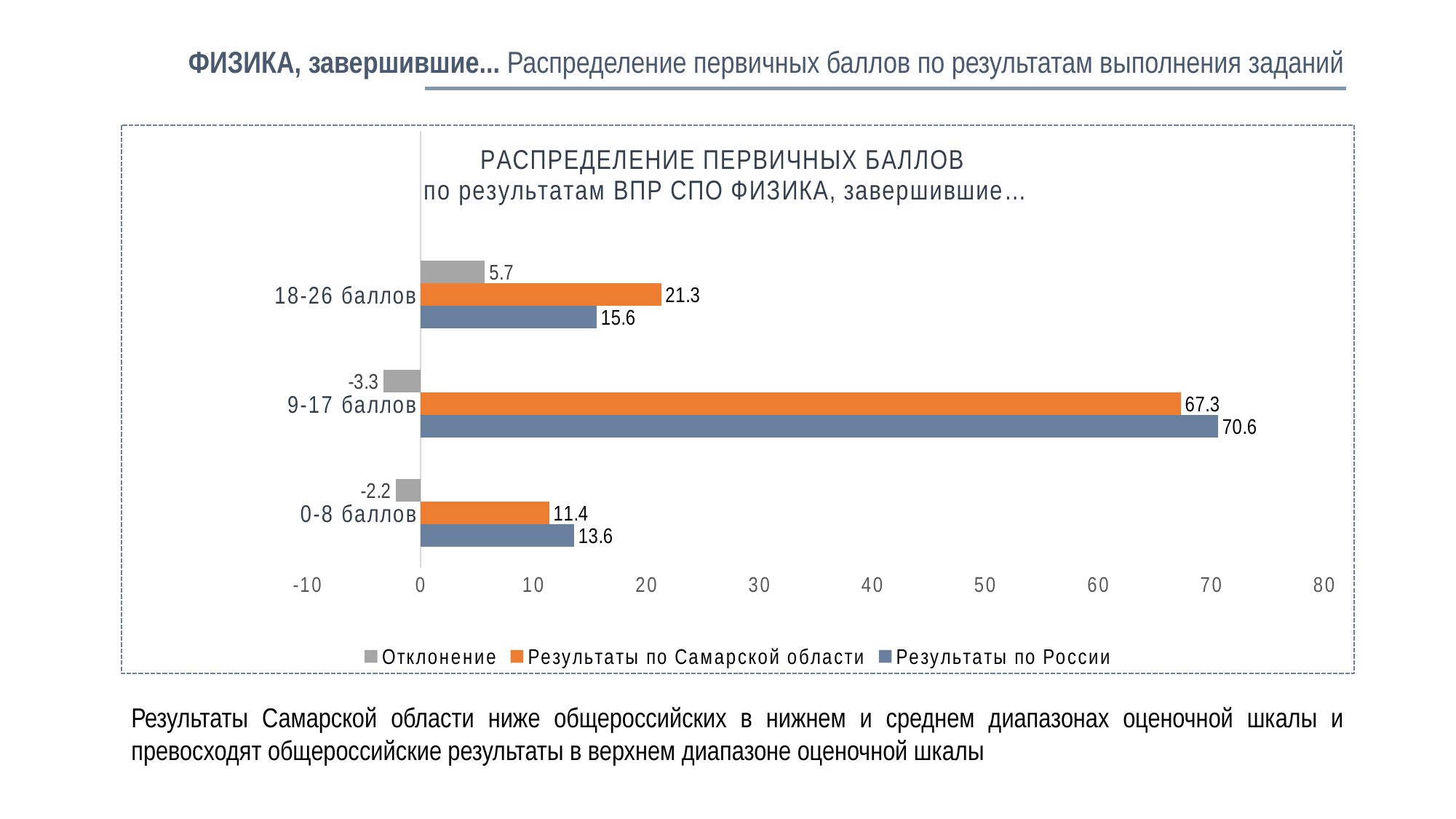
What is the Отклонение value for the 0-8 баллов category? -2.2 How many score-range categories are shown on the chart? 3 Which category has the highest value for Результаты по России? 9-17 баллов Which category has the lowest value for Результаты по Самарской области? 0-8 баллов In the 18-26 баллов category, which is larger: Результаты по Самарской области or Результаты по России? Результаты по Самарской области What is the difference between Результаты по России and Результаты по Самарской области in the 9-17 баллов category? 3.3 What is the value for Результаты по Самарской области in the 9-17 баллов category? 67.3 Is the value for Результаты по России in the 9-17 баллов category greater or less than 60? greater What kind of chart is shown on the slide? Bar chart Which series is shown in orange? Результаты по Самарской области What is the value for Результаты по России in the 18-26 баллов category? 15.6 How many series does the legend list? 3